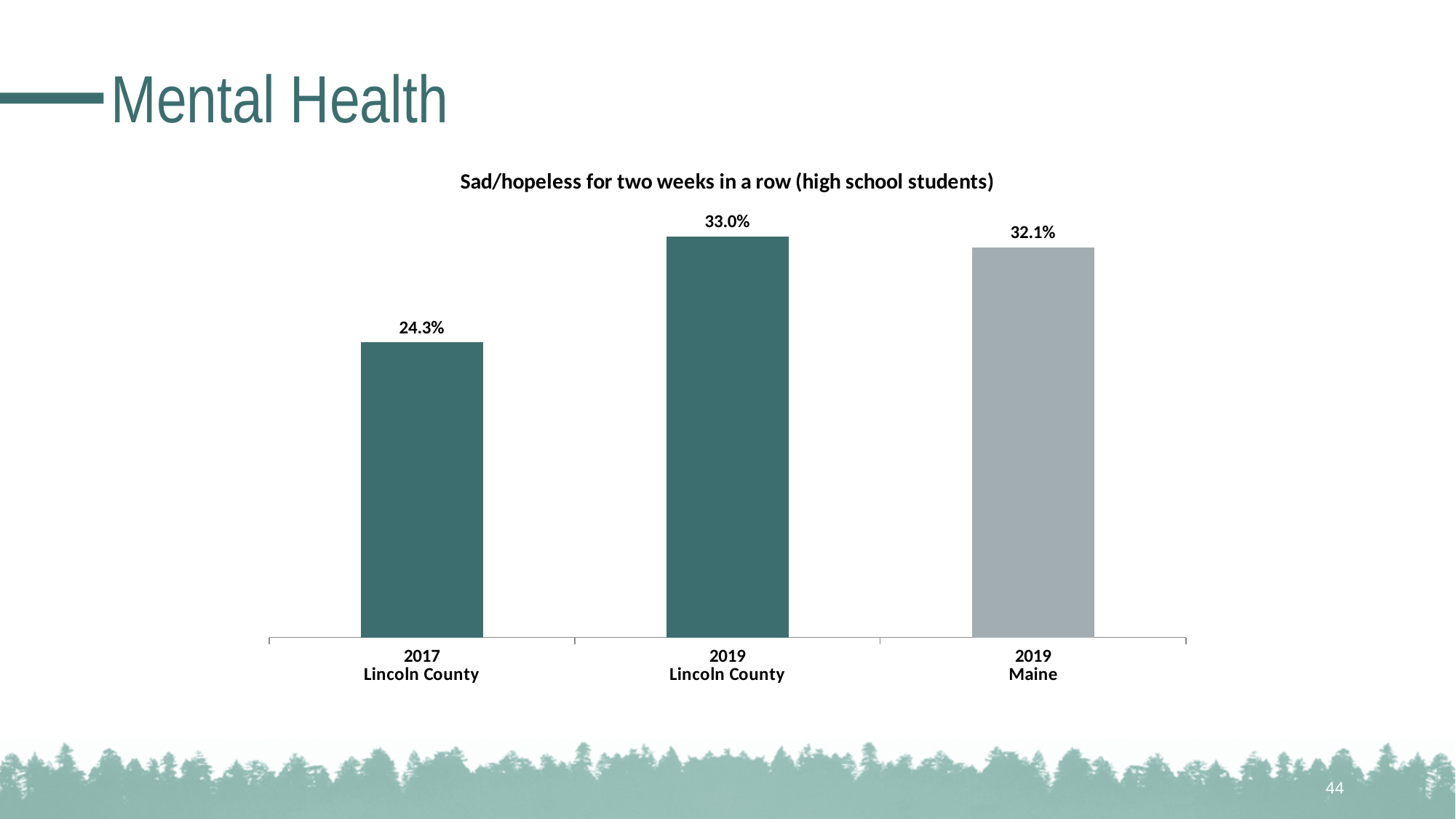
Which category has the lowest value? 2017 Lincoln County What is the value for 2019 Lincoln County? 33.0% What is the value for 2017 Lincoln County? 24.3% What is the value for 2019 Maine? 32.1% Which is larger, the value for 2017 Lincoln County or the value for 2019 Maine? 2019 Maine Which category has the highest value? 2019 Lincoln County How many bars are shown in the chart? 3 What is the difference between the 2019 Lincoln County value and the 2019 Maine value? 0.9% Did the Lincoln County value rise or fall from 2017 to 2019? Rise What is the title of the chart? Sad/hopeless for two weeks in a row (high school students) What is the difference between the 2019 Lincoln County value and the 2017 Lincoln County value? 8.7% What kind of chart is shown on the slide? Bar chart